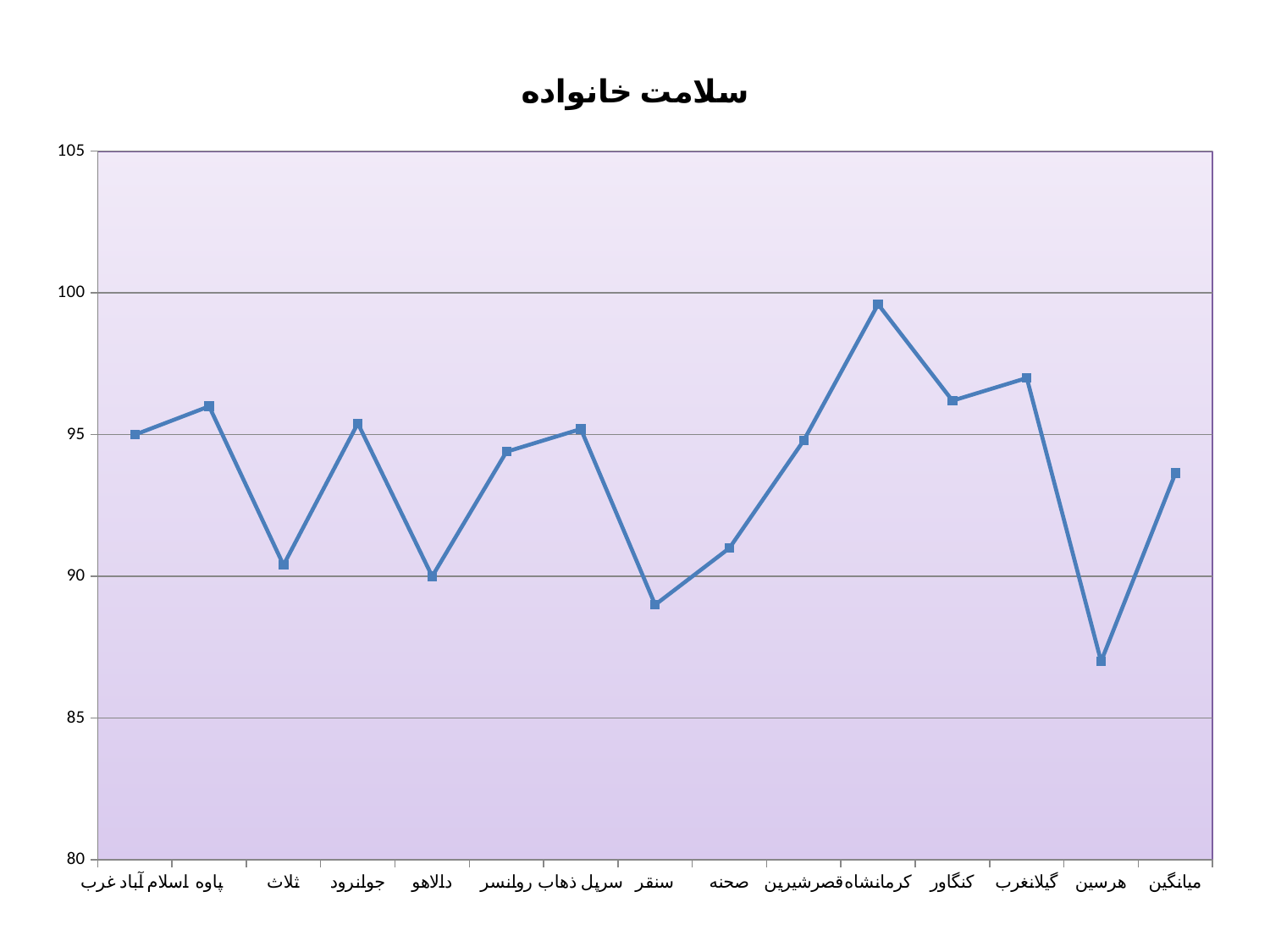
What kind of chart is shown on the slide? line chart How many categories are plotted along the x axis? 15 Which category has the lowest value? هرسین Is the value for میانگین greater or less than 90? greater Is the value for گیلانغرب greater or less than 95? greater What is the title of the chart? سلامت خانواده Which has the larger value, پاوه or ثلاث? پاوه Is the value for هرسین greater or less than 90? less Which has the larger value, صحنه or قصرشیرین? قصرشیرین Which category has the highest value? کرمانشاه